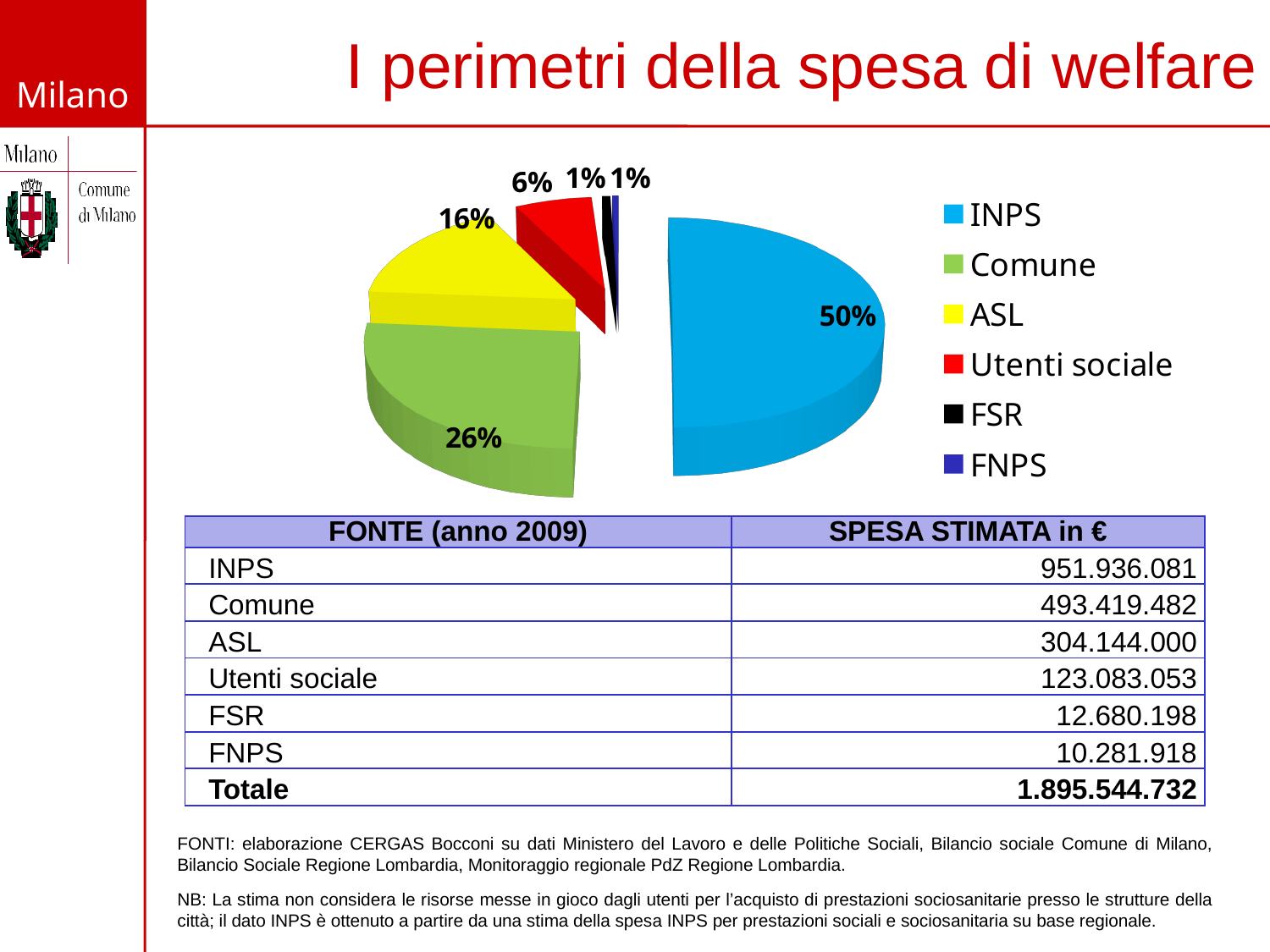
Which category has the largest slice of the pie? INPS What percentage is shown for ASL in the pie chart? 16% What colour is the INPS slice in the pie chart? blue What percentage is shown for FSR in the pie chart? 1% What is the title of the slide containing the pie chart? I perimetri della spesa di welfare What type of chart is shown on the slide? pie chart What share of the pie does INPS represent? 50% How many entries does the legend of the pie chart list? 6 Which slice is larger, Comune or ASL? Comune What percentage is shown for Utenti sociale in the pie chart? 6% What is the difference in percentage points between the INPS slice and the Comune slice? 24% What percentage is shown for Comune in the pie chart? 26%